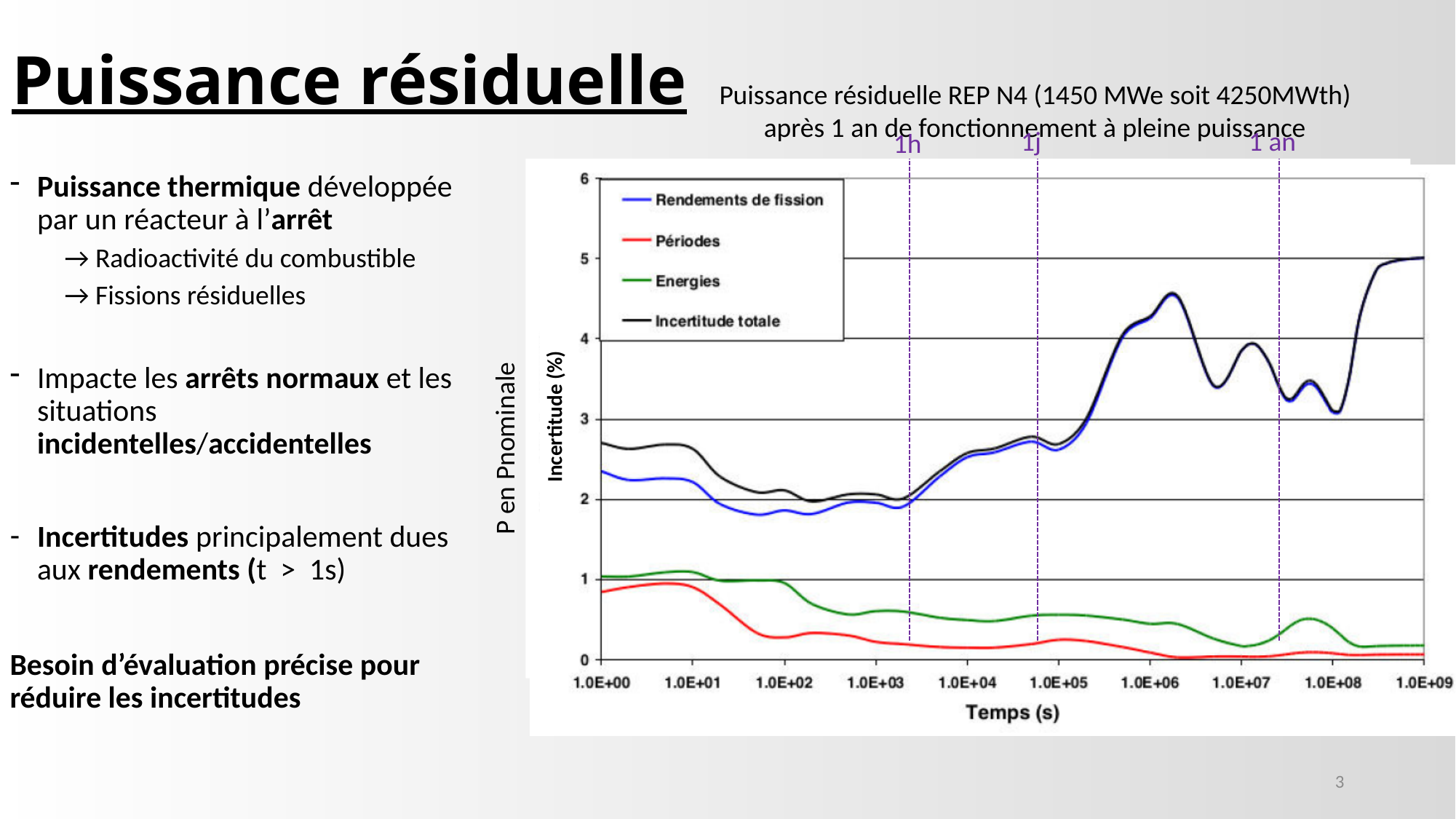
Is the value of Incertitude totale at 1.0E+06 s greater or less than 4? greater Does the Périodes curve rise or fall between 1.0E+01 s and 1.0E+02 s? fall What is the label of the y axis of the chart? Incertitude (%) What kind of chart is shown on the slide? line chart Is the value of Rendements de fission at 1.0E+02 s greater or less than 2? less How many series does the chart legend list? 4 Is the value of Energies at 1.0E+04 s greater or less than 1? less Does the Incertitude totale curve rise or fall between 1.0E+03 s and 1.0E+06 s? rise At 1.0E+09 s, which is larger: Incertitude totale or Périodes? Incertitude totale Which series has the lowest value at 1.0E+09 s? Périodes